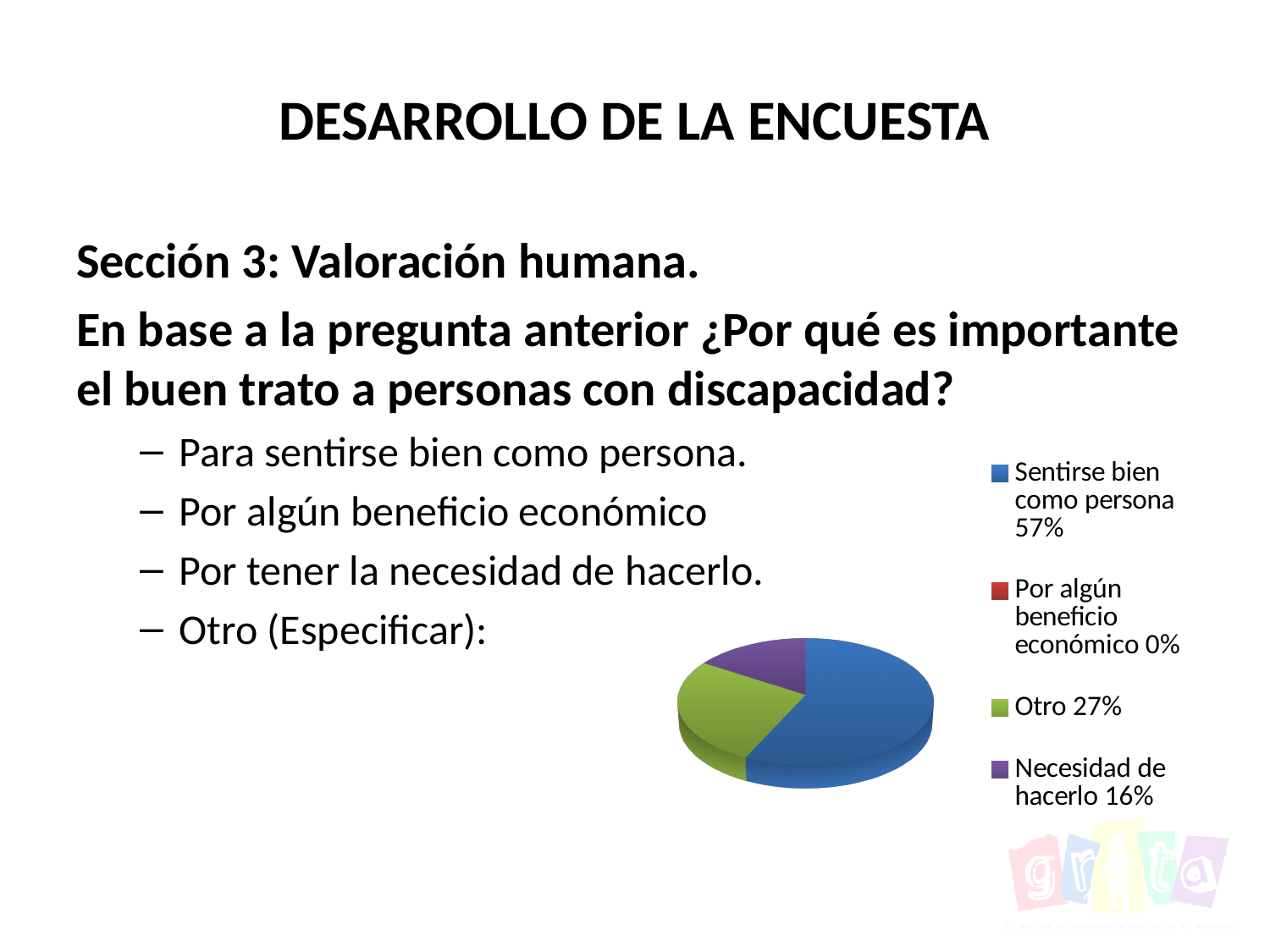
Which is larger, the share for "Otro" or the share for "Necesidad de hacerlo"? Otro What share of the pie does "Sentirse bien como persona" represent? 57% What kind of chart is shown on the slide? pie chart What share of the pie does "Por algún beneficio económico" represent? 0% What share of the pie does "Otro" represent? 27% What is the difference in percentage points between "Otro" and "Necesidad de hacerlo"? 11 What colour is the slice for "Otro" in the pie chart? green Which category has the smallest share of the pie? Por algún beneficio económico How many categories does the legend of the pie chart list? 4 What is the difference in percentage points between "Sentirse bien como persona" and "Otro"? 30 Which category has the largest share of the pie? Sentirse bien como persona